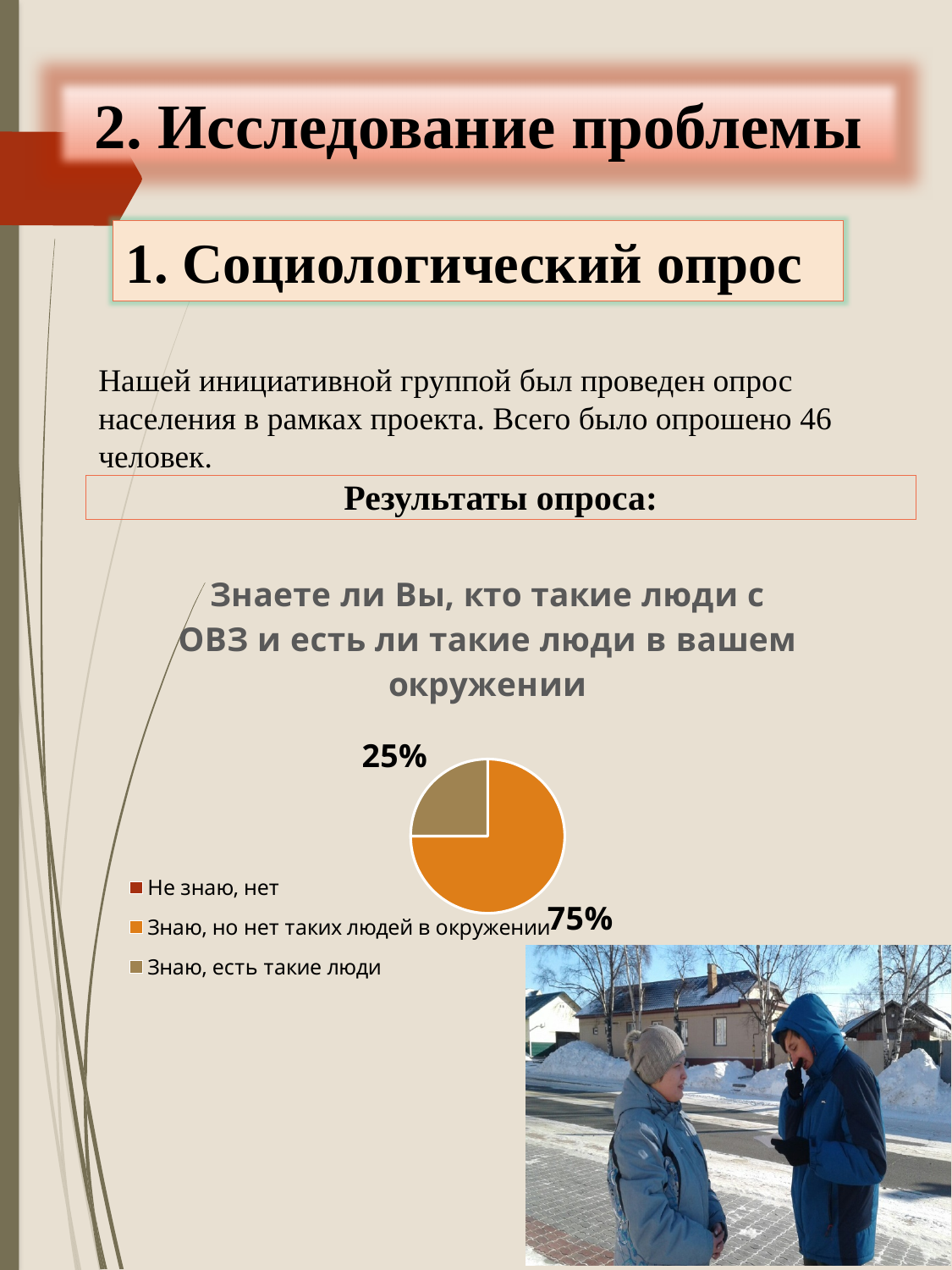
Is the share for "Знаю, есть такие люди" greater or less than 50%? less What share of the pie does the slice "Знаю, но нет таких людей в окружении" take? 75% How many entries does the chart legend list? 3 Which is larger: the slice for "Знаю, есть такие люди" or the slice for "Знаю, но нет таких людей в окружении"? Знаю, но нет таких людей в окружении What is the title of the pie chart? Знаете ли Вы, кто такие люди с ОВЗ и есть ли такие люди в вашем окружении Which legend category has the largest slice of the pie? Знаю, но нет таких людей в окружении How many slices are visible in the pie? 2 What kind of chart is shown on the slide? pie chart Which legend entry is shown in orange? Знаю, но нет таких людей в окружении What share of the pie does the slice "Знаю, есть такие люди" take? 25% By how many percentage points does the "Знаю, но нет таких людей в окружении" slice exceed the "Знаю, есть такие люди" slice? 50